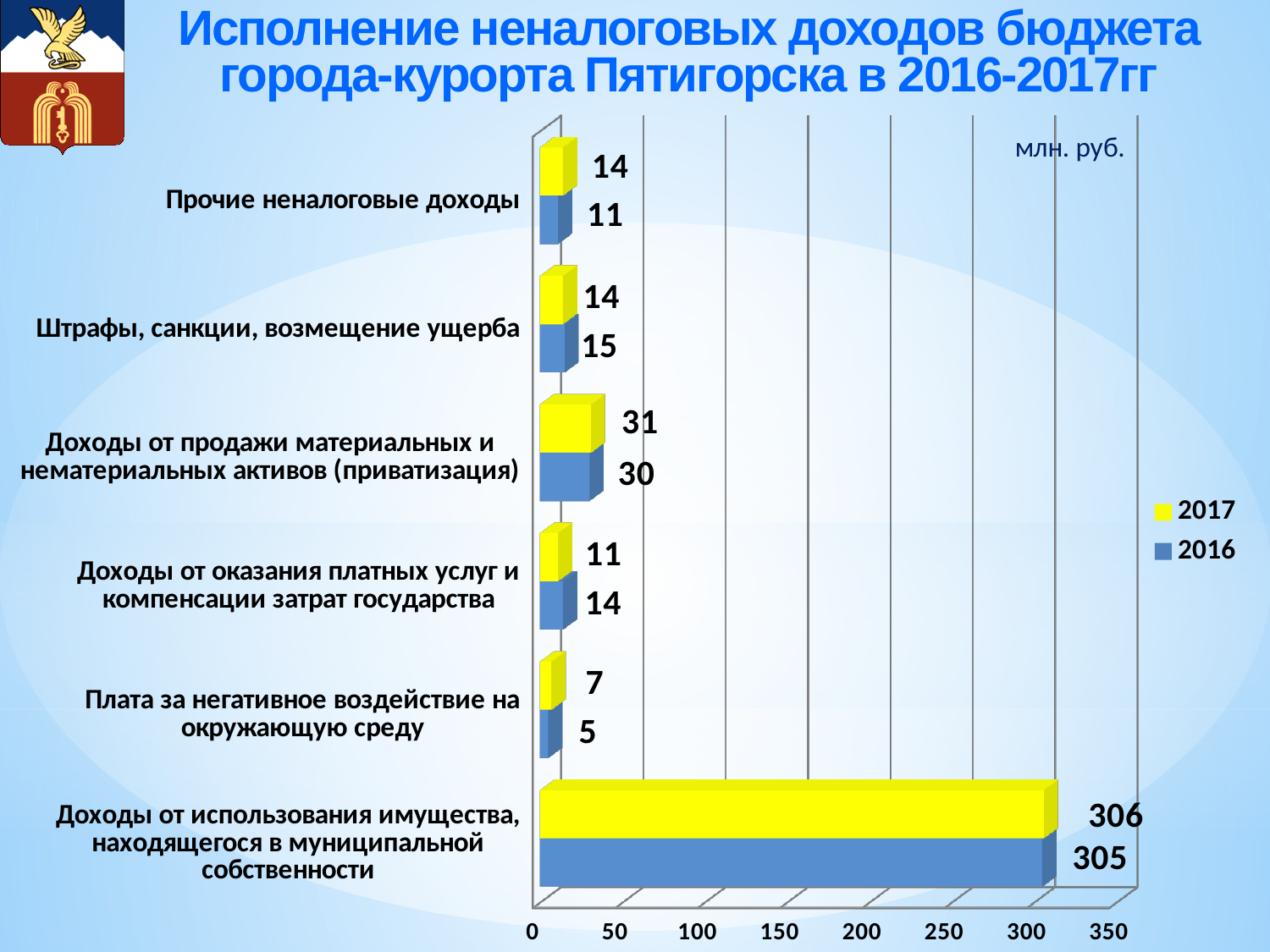
Is the 2016 value for «Доходы от использования имущества, находящегося в муниципальной собственности» greater or less than 300? greater What is the difference between the 2017 and 2016 values for «Прочие неналоговые доходы»? 3 What type of chart is shown on the slide? Bar chart What is the 2016 value for «Доходы от оказания платных услуг и компенсации затрат государства»? 14 Which category has the lowest 2016 value? Плата за негативное воздействие на окружающую среду For «Доходы от оказания платных услуг и компенсации затрат государства», which year has the larger value, 2016 or 2017? 2016 Which category has the highest 2017 value? Доходы от использования имущества, находящегося в муниципальной собственности What is the 2017 value for «Плата за негативное воздействие на окружающую среду»? 7 What is the 2017 value for «Доходы от использования имущества, находящегося в муниципальной собственности»? 306 How many series does the legend list? 2 How many categories are shown on the chart? 6 What is the 2016 value for «Штрафы, санкции, возмещение ущерба»? 15